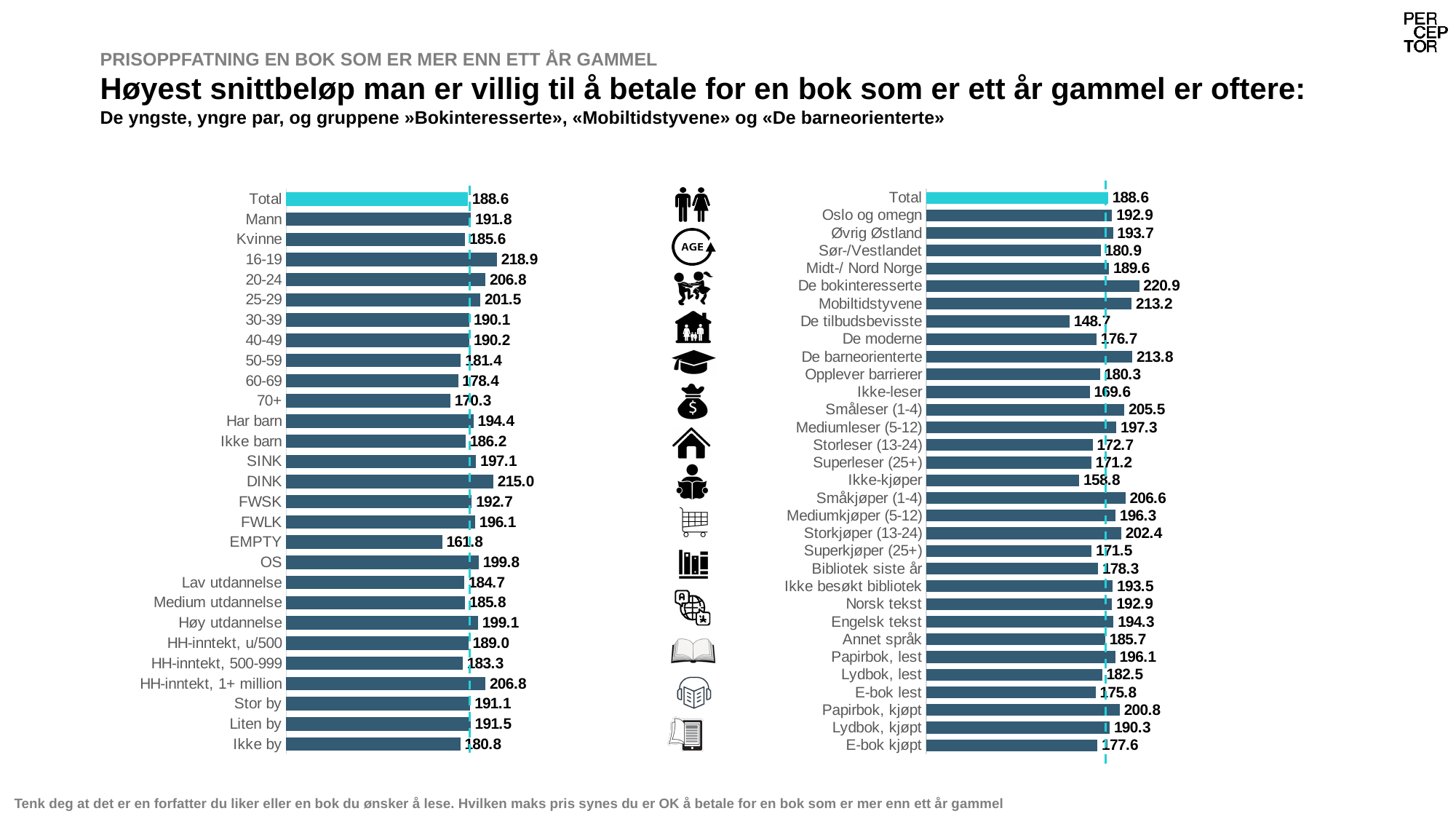
What kind of chart is the left chart? Bar chart In the left chart, what is the value for 16-19? 218.9 In the right chart, what is the difference between the values for Mobiltidstyvene and De barneorienterte? 0.6 In the left chart, what is the value for DINK? 215.0 In the left chart, what is the difference between the values for Mann and Kvinne? 6.2 In the right chart, which category has the lowest value? De tilbudsbevisste How many categories are plotted in the right chart? 32 In the left chart, which is larger, the value for Har barn or Ikke barn? Har barn In the left chart, which category has the highest value? 16-19 In the right chart, which category has the highest value? De bokinteresserte In the left chart, which category has the lowest value? EMPTY In the right chart, what is the value for De tilbudsbevisste? 148.7